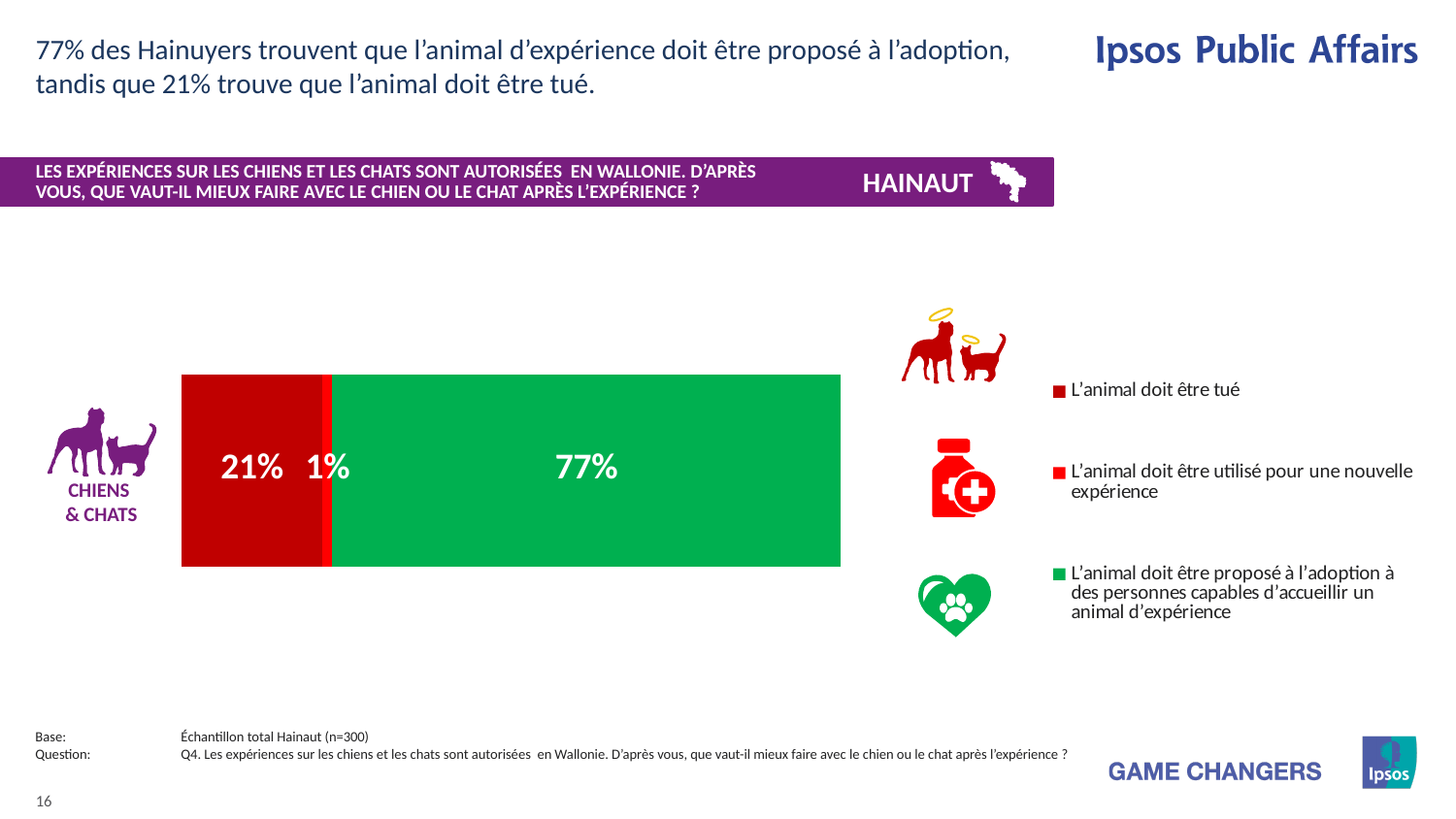
Which response option has the highest share in the bar? L'animal doit être proposé à l'adoption à des personnes capables d'accueillir un animal d'expérience Which is larger: the share for "L'animal doit être tué" or the share for "L'animal doit être utilisé pour une nouvelle expérience"? L'animal doit être tué How many series does the legend list? 3 What is the total of the three segments in the stacked bar? 99% What percentage of respondents say the animal should be offered for adoption ("L'animal doit être proposé à l'adoption")? 77% What is the difference between the share for adoption (77%) and the share for the animal being killed (21%)? 56 percentage points What colour is the segment representing "L'animal doit être proposé à l'adoption"? Green What kind of chart is shown on the slide? Stacked bar chart Which response option has the lowest share in the bar? L'animal doit être utilisé pour une nouvelle expérience How many categories (bars) are plotted in the chart? 1 What percentage of respondents say the animal should be used for a new experiment ("L'animal doit être utilisé pour une nouvelle expérience")? 1% What percentage of respondents say the animal should be killed ("L'animal doit être tué")? 21%